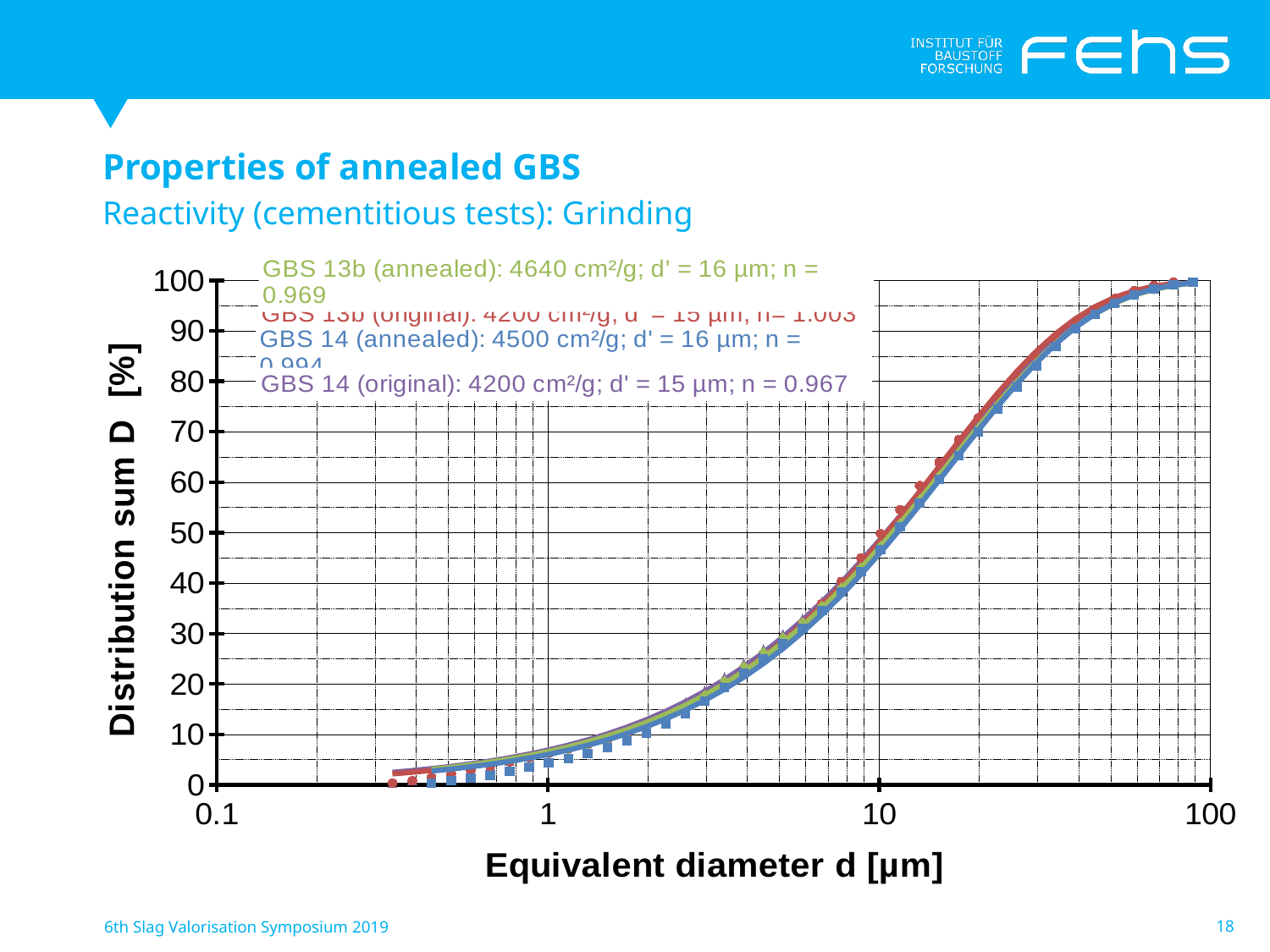
What is the label of the x axis? Equivalent diameter d [µm] Is the distribution sum D at an equivalent diameter of 20 µm greater or less than 60%? greater What is the highest value shown on the y axis? 100 Is the distribution sum D at an equivalent diameter of 1 µm greater or less than 10%? less According to the legend, what specific surface is given for GBS 13b (annealed)? 4640 cm²/g Is the distribution sum D at an equivalent diameter of 10 µm greater or less than 40%? greater How many series does the legend list? 4 Do the distribution sum values rise or fall as the equivalent diameter increases along the x axis? rise What kind of chart is shown on the slide? line chart What is the highest value shown on the x axis? 100